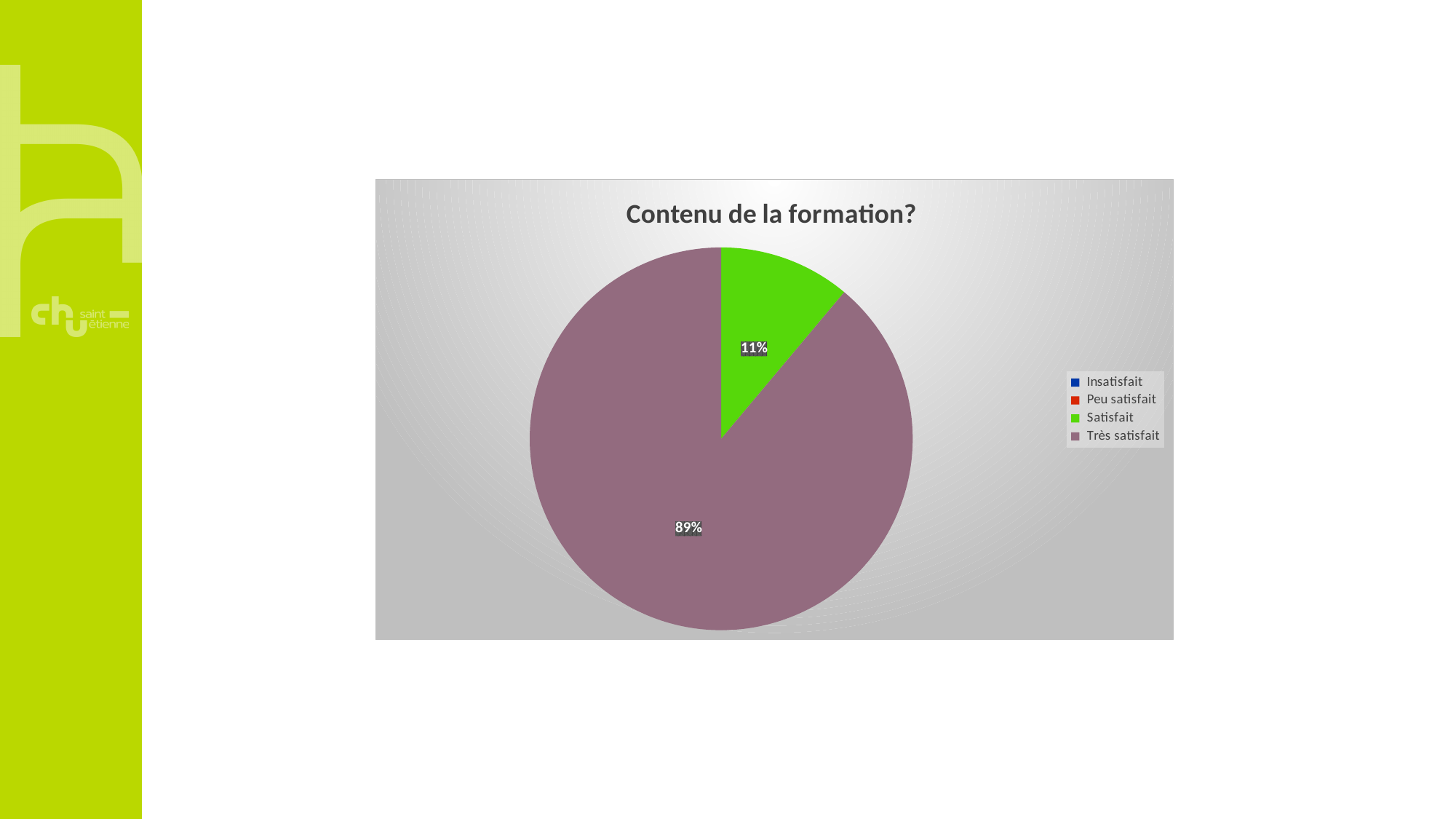
Which category has the largest slice of the pie? Très satisfait What is the difference in percentage points between the "Très satisfait" and "Satisfait" slices? 78 What share of the pie is labelled for "Satisfait"? 11% Which is larger, the slice for "Satisfait" or the slice for "Très satisfait"? Très satisfait How many entries does the legend list? 4 What colour is the "Satisfait" slice? green How many slices are visible in the pie? 2 What share of the pie is labelled for "Très satisfait"? 89% What kind of chart is shown on the slide? pie chart What is the title of the chart? Contenu de la formation?